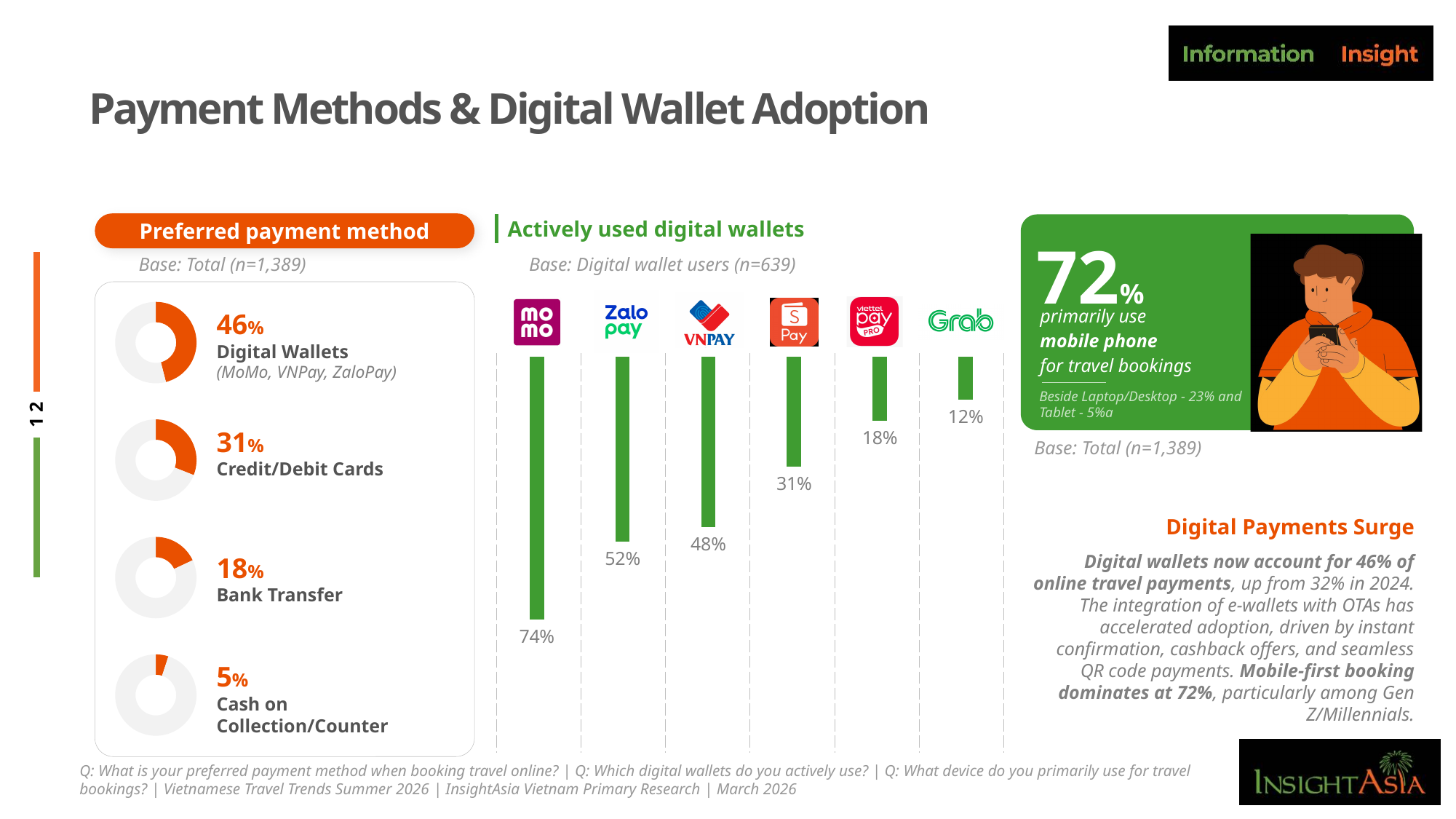
What kind of chart is 'Actively used digital wallets'? Bar chart In the 'Preferred payment method' chart, what is the difference between Digital Wallets and Bank Transfer? 28% In the 'Actively used digital wallets' chart, what is the value for MoMo? 74% In the 'Actively used digital wallets' chart, how many wallets are shown? 6 In the 'Preferred payment method' chart, which method has the lowest value? Cash on Collection/Counter In the 'Actively used digital wallets' chart, do the values rise or fall from left to right? Fall In the 'Preferred payment method' chart, what is the value for Credit/Debit Cards? 31% In the 'Actively used digital wallets' chart, what is the value for ZaloPay? 52% In the 'Actively used digital wallets' chart, what is the value for Grab? 12% In the 'Actively used digital wallets' chart, which wallet has the highest value? MoMo In the 'Actively used digital wallets' chart, which wallet has the lowest value? Grab In the 'Actively used digital wallets' chart, what is the difference between ZaloPay and VNPAY? 4%